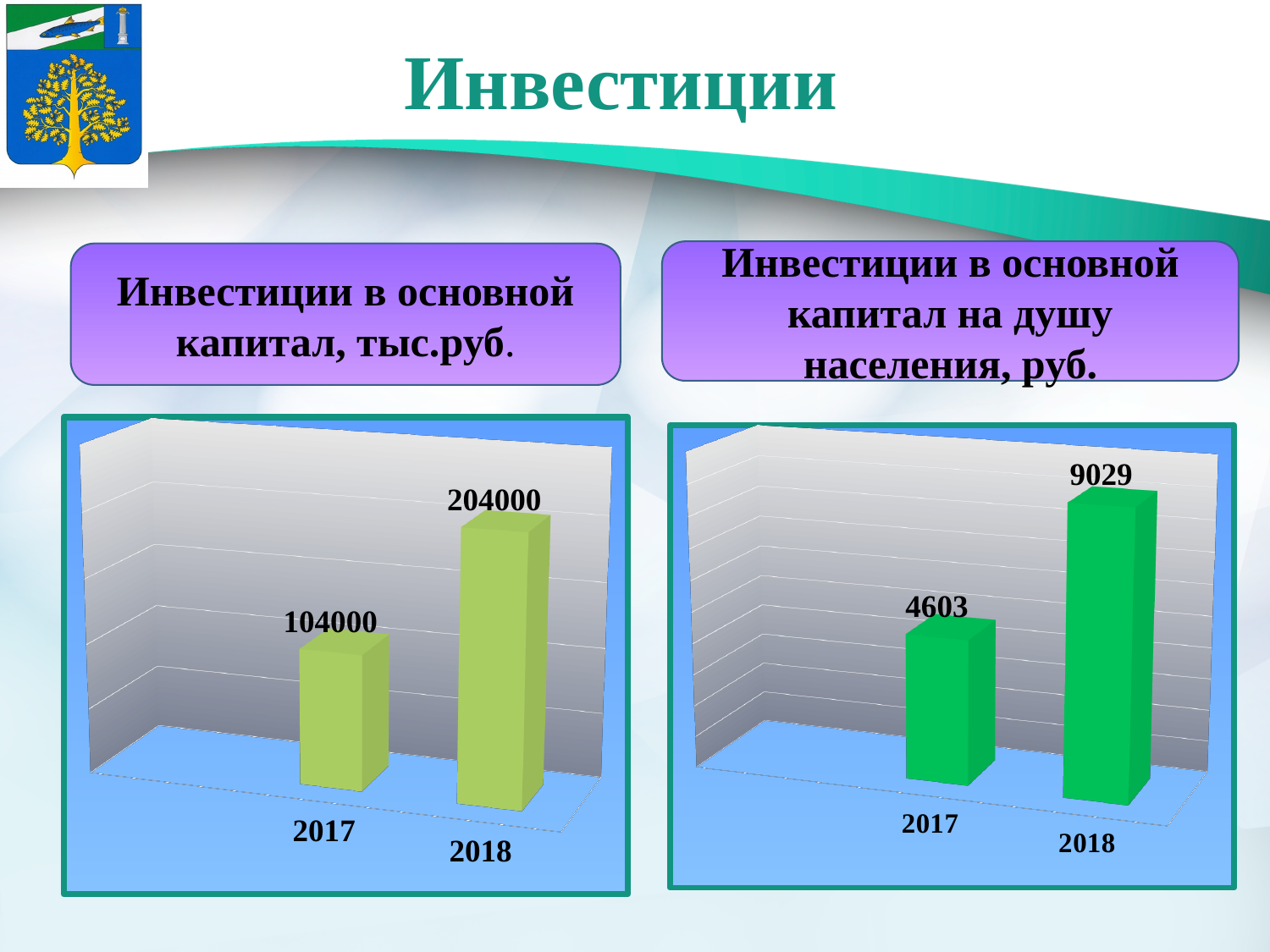
In the right chart, what is the difference between the 2018 and 2017 values? 4426 How many bars does the left chart show? 2 In the right chart (Инвестиции в основной капитал на душу населения, руб.), what is the value for 2017? 4603 In the right chart (Инвестиции в основной капитал на душу населения, руб.), what is the value for 2018? 9029 In the left chart (Инвестиции в основной капитал, тыс.руб.), what is the value for 2018? 204000 In the left chart, do the values rise or fall from 2017 to 2018? rise In the right chart, is the value for 2018 larger or smaller than the value for 2017? larger In the left chart, which year has the higher value? 2018 In the left chart, what is the difference between the 2018 and 2017 values? 100000 In the right chart, which year has the lower value? 2017 What kind of chart is the right chart? bar chart In the left chart (Инвестиции в основной капитал, тыс.руб.), what is the value for 2017? 104000